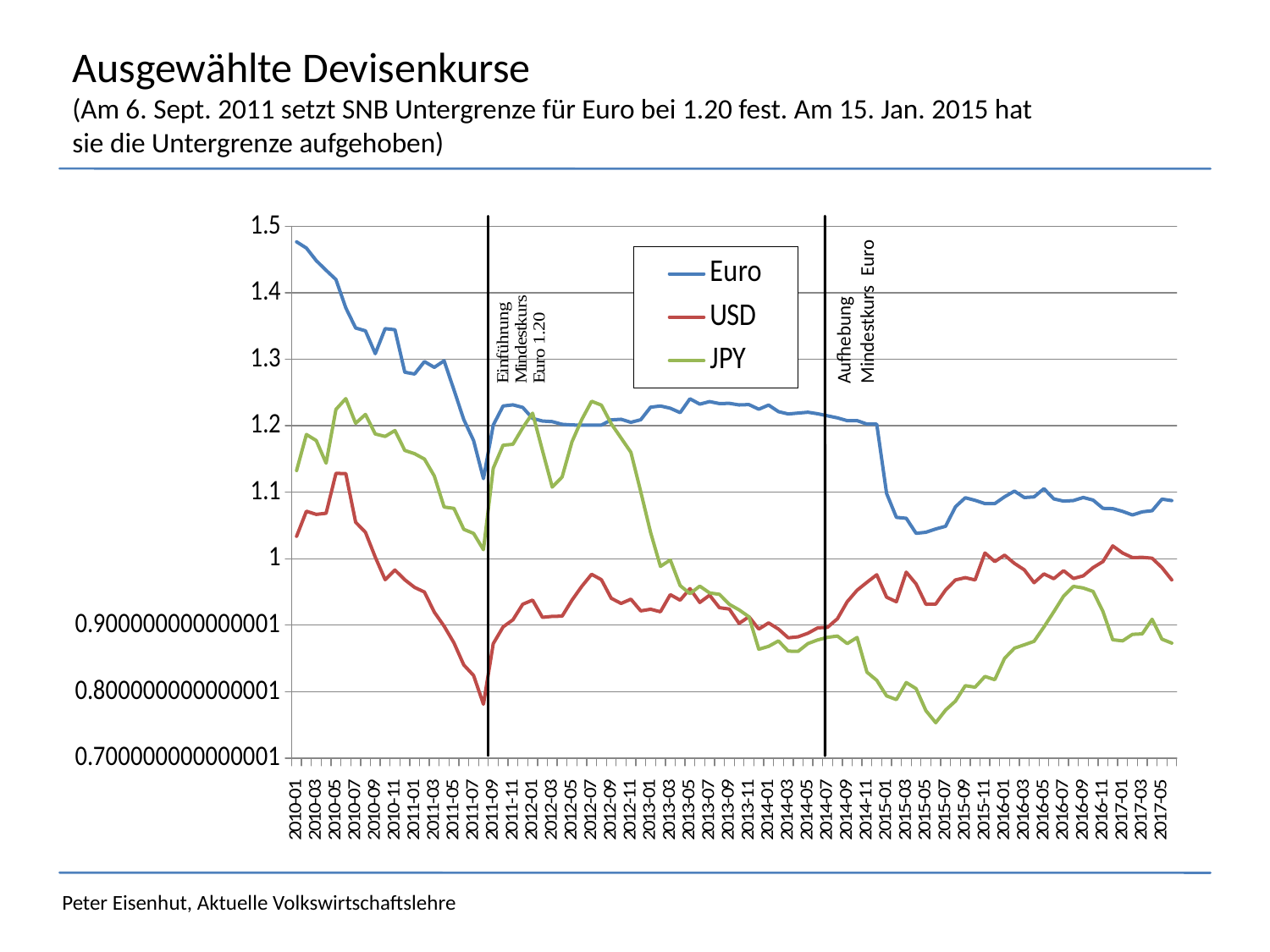
What kind of chart is shown on the slide? line chart Is the value for JPY at 2015-06 greater or less than 0.8? less Is the value for Euro at 2010-01 greater or less than 1.4? greater Which is larger at 2010-01, the Euro value or the USD value? Euro Is the value for USD at 2011-08 greater or less than 0.8? less How many series does the legend list? 3 Which series are listed in the legend? Euro, USD, JPY Which is larger at 2015-06, the USD value or the JPY value? USD Does the Euro series rise or fall from 2010-01 to 2011-08? fall Which series has the highest value at 2017-05? Euro What is the title of the chart? Ausgewählte Devisenkurse